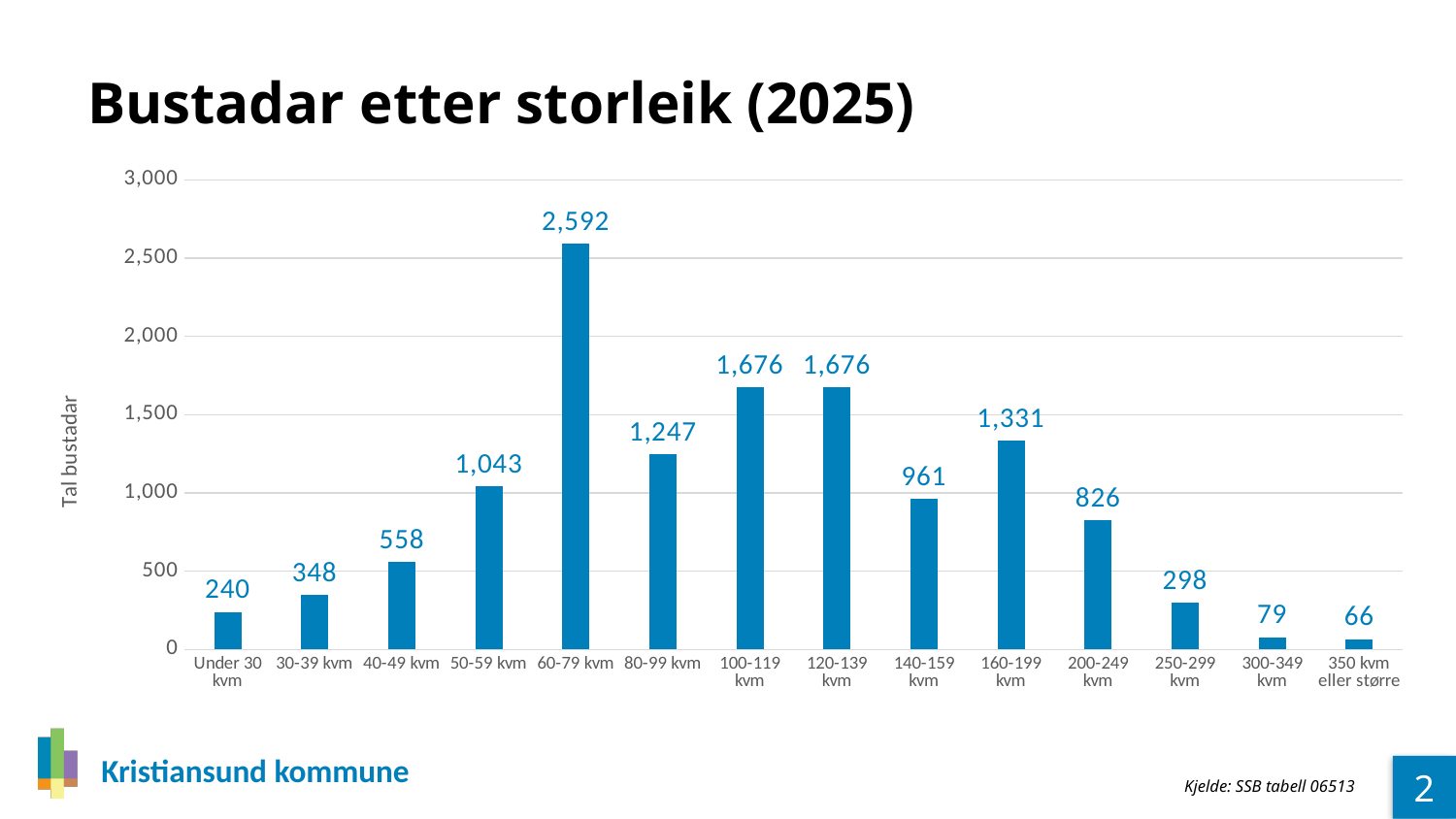
How many size categories are shown on the x axis? 14 Which is larger, the value for 140-159 kvm or the value for 160-199 kvm? 160-199 kvm What is the difference between the values for 80-99 kvm and 50-59 kvm? 204 What is the value for 350 kvm eller større? 66 What kind of chart is shown on the slide? bar chart Is the value for 200-249 kvm greater or less than 1,000? less What is the value for 60-79 kvm? 2,592 What is the label on the y axis? Tal bustadar Which size category has the lowest number of dwellings? 350 kvm eller større What is the value for 160-199 kvm? 1,331 What is the difference between the values for 60-79 kvm and 100-119 kvm? 916 Which size category has the highest number of dwellings? 60-79 kvm